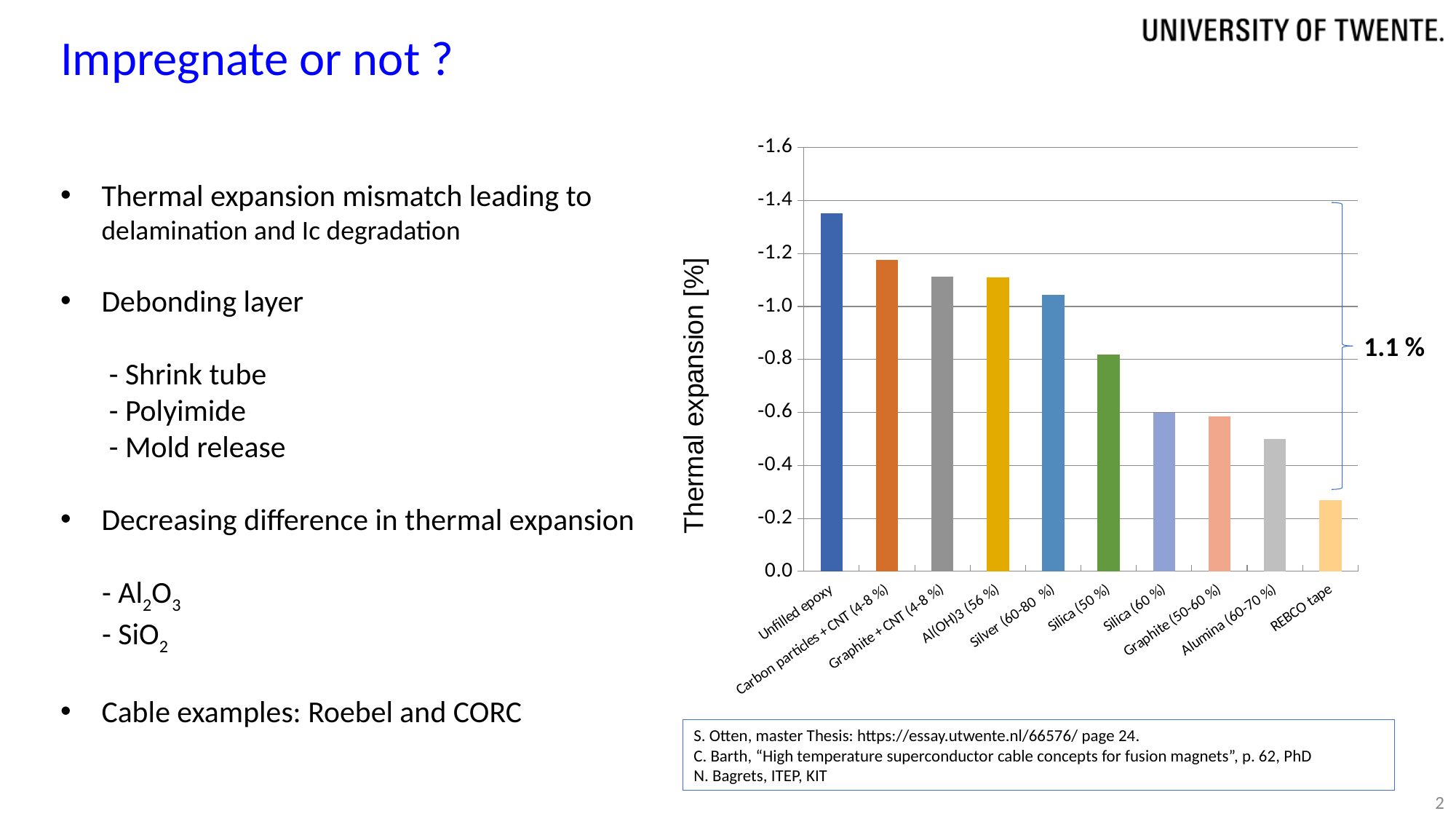
Is the magnitude of the thermal expansion for Unfilled epoxy greater or less than 1.2%? greater What is the label of the vertical axis of the chart? Thermal expansion [%] What kind of chart is shown on the slide? bar chart Which has the more negative thermal expansion, Unfilled epoxy or Silver (60-80 %)? Unfilled epoxy How many materials (bars) are plotted in the chart? 10 Which material has the smallest (least negative) thermal expansion in the chart? REBCO tape Is the magnitude of the thermal expansion for Silica (50 %) greater or less than 1.0%? less Which has the more negative thermal expansion, Silica (50 %) or Silica (60 %)? Silica (50 %) Which material has the largest (most negative) thermal expansion in the chart? Unfilled epoxy What value is annotated next to the bracket on the right side of the chart? 1.1 % Is the magnitude of the thermal expansion for REBCO tape greater or less than 0.4%? less Moving from left to right across the categories, does the magnitude of the thermal expansion increase or decrease? decrease